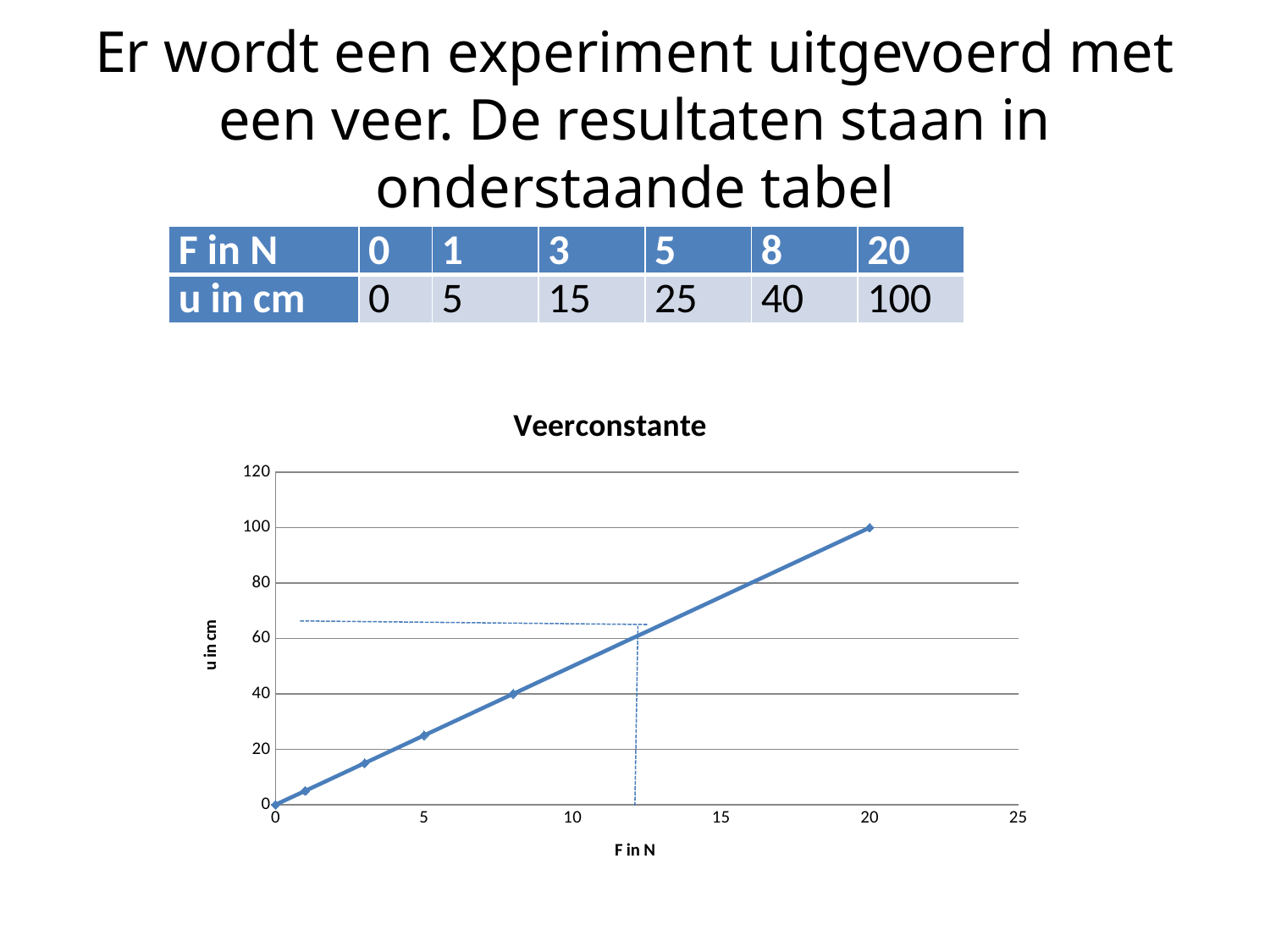
Do the values of u rise or fall as F increases along the x axis? rise What is the title of the chart? Veerconstante What is the value of u in cm when F is 20 N? 100 What type of chart is shown on the slide? line chart At which value of F in N is u the highest? 20 What is the value of u in cm when F is 8 N? 40 At which value of F in N is u the lowest? 0 What is the difference in u between F = 20 N and F = 8 N? 60 What is the label of the vertical axis of the chart? u in cm Which is larger: u at F = 5 N or u at F = 8 N? u at F = 8 N How many data points are plotted on the chart? 6 What is the value of u in cm when F is 3 N? 15